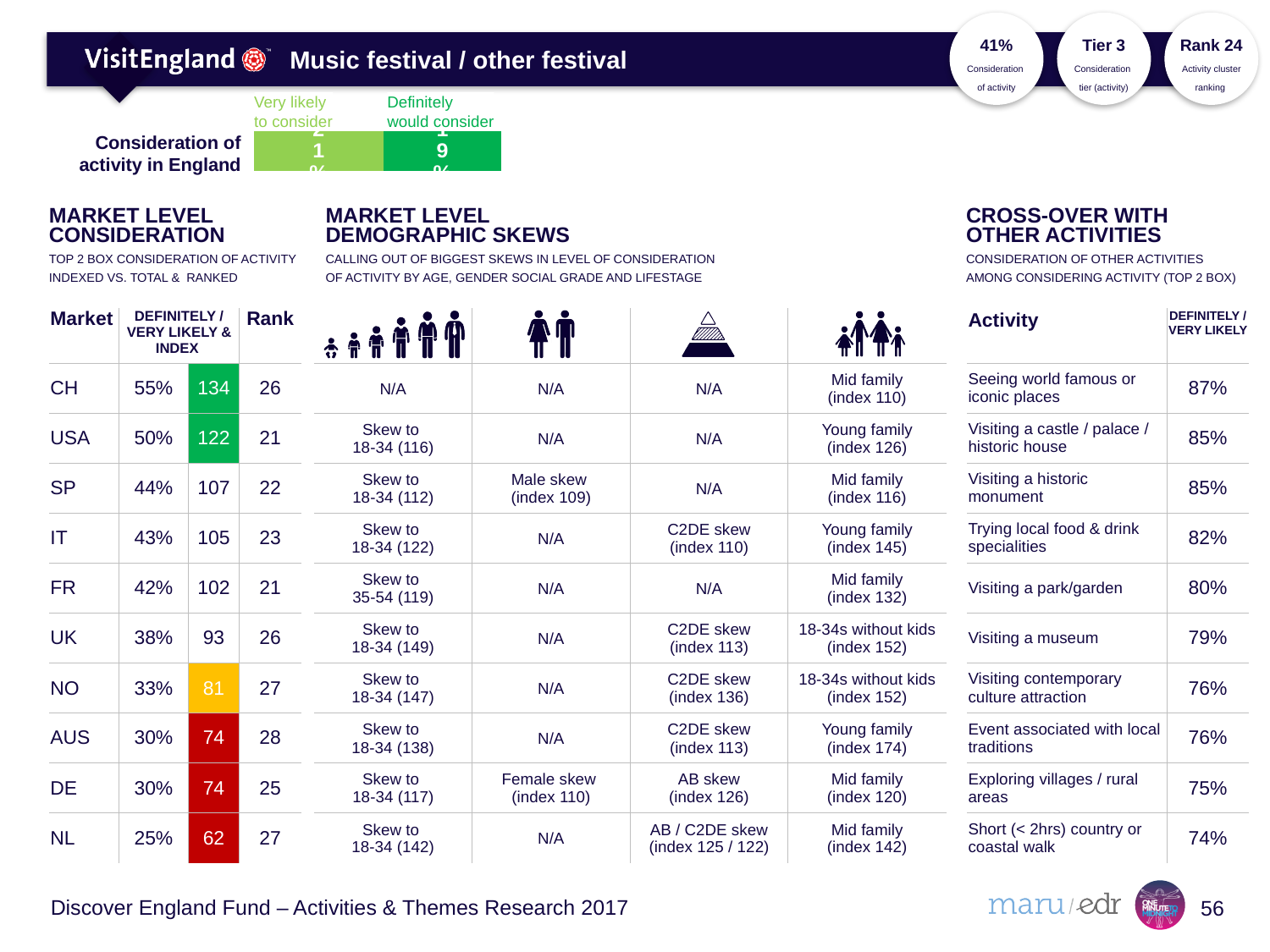
How many series does the legend of the 'Consideration of activity in England' chart list? 2 What are the two legend entries of the 'Consideration of activity in England' chart? Very likely to consider; Definitely would consider What kind of chart is the 'Consideration of activity in England' chart? bar chart In the 'Consideration of activity in England' chart, what is the difference between 'Very likely to consider' and 'Definitely would consider'? 2% In the 'Consideration of activity in England' chart, which is larger: 'Very likely to consider' or 'Definitely would consider'? Very likely to consider Which segment of the 'Consideration of activity in England' bar is shown in the darker green? Definitely would consider In the 'Consideration of activity in England' chart, what is the value for 'Very likely to consider'? 21% In the 'Consideration of activity in England' chart, what is the value for 'Definitely would consider'? 19%